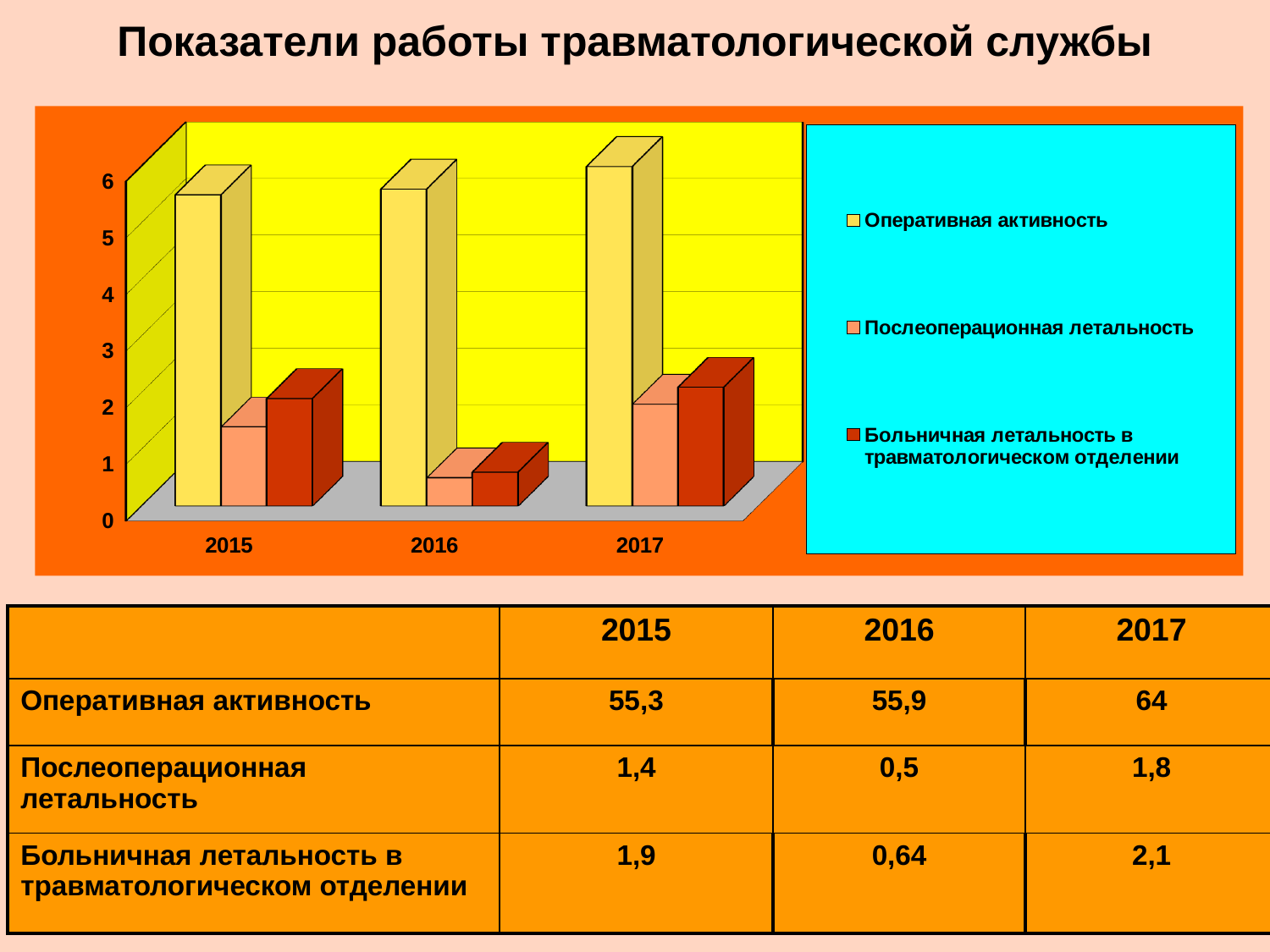
What is the difference between Послеоперационная летальность in 2017 and in 2016? 1,3 Is the bar for Больничная летальность в травматологическом отделении in 2016 greater or less than 1? less What kind of chart is shown on the slide? bar chart In which year is Оперативная активность highest? 2017 Does Оперативная активность rise or fall from 2015 to 2017? rise What is the value of Послеоперационная летальность for 2016? 0,5 What is the value of Оперативная активность for 2017? 64 What is the value of Больничная летальность в травматологическом отделении for 2015? 1,9 In which year is Послеоперационная летальность lowest? 2016 How many series does the chart legend list? 3 In 2015, which is larger: Послеоперационная летальность or Больничная летальность в травматологическом отделении? Больничная летальность в травматологическом отделении How many years are shown on the x axis of the chart? 3